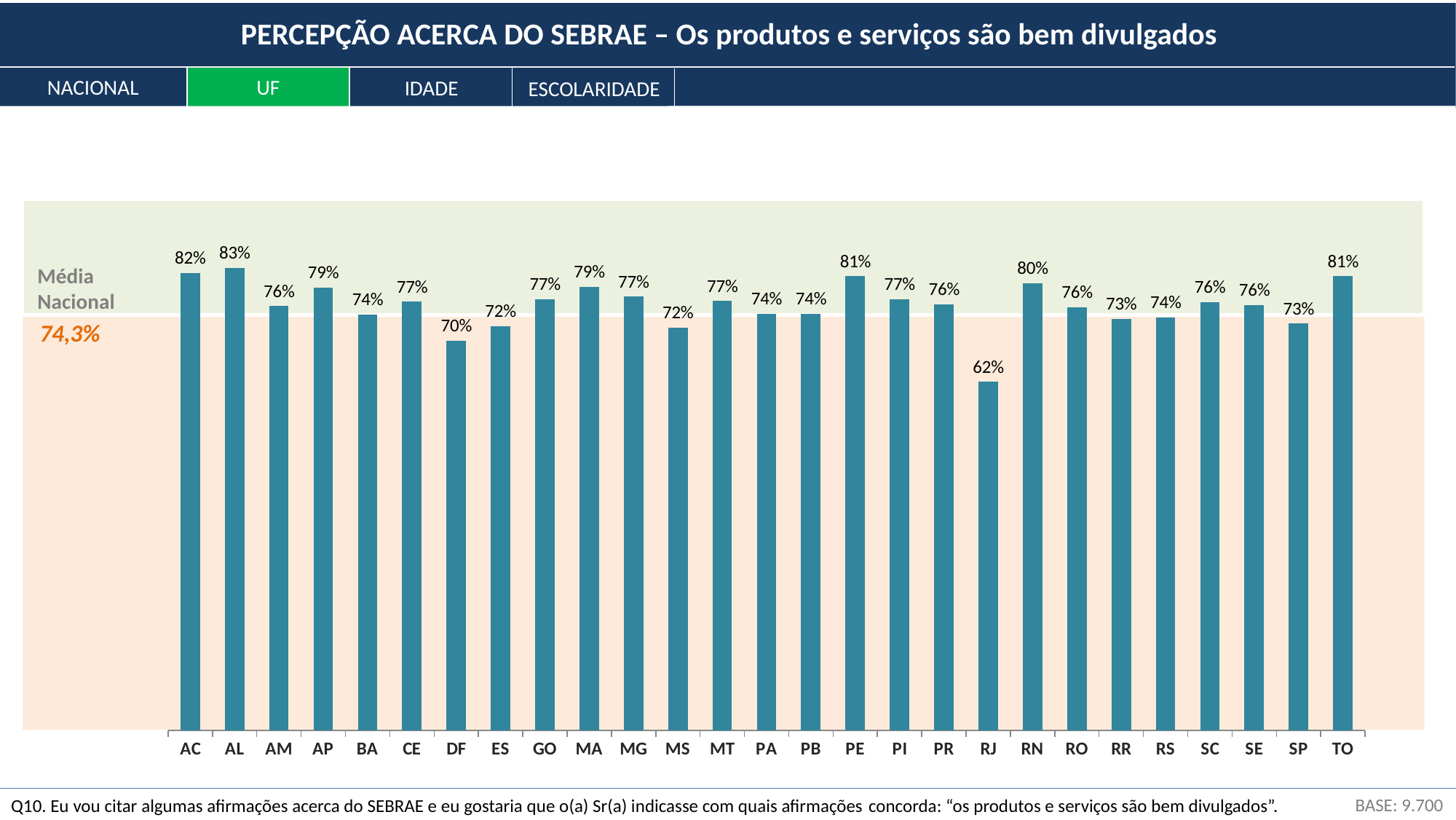
What is the value for AL? 83% What is the difference between the values for PE and SP? 8% What kind of chart is shown on the slide? Bar chart Which state has the lowest value? RJ Which has a larger value, AC or AM? AC Which state has the highest value? AL What is the value for DF? 70% How many states (UFs) are shown on the x axis? 27 What is the difference between the values for AL and RJ? 21% What is the value for RN? 80% What is the Média Nacional value shown on the chart? 74,3% What is the value for RJ? 62%